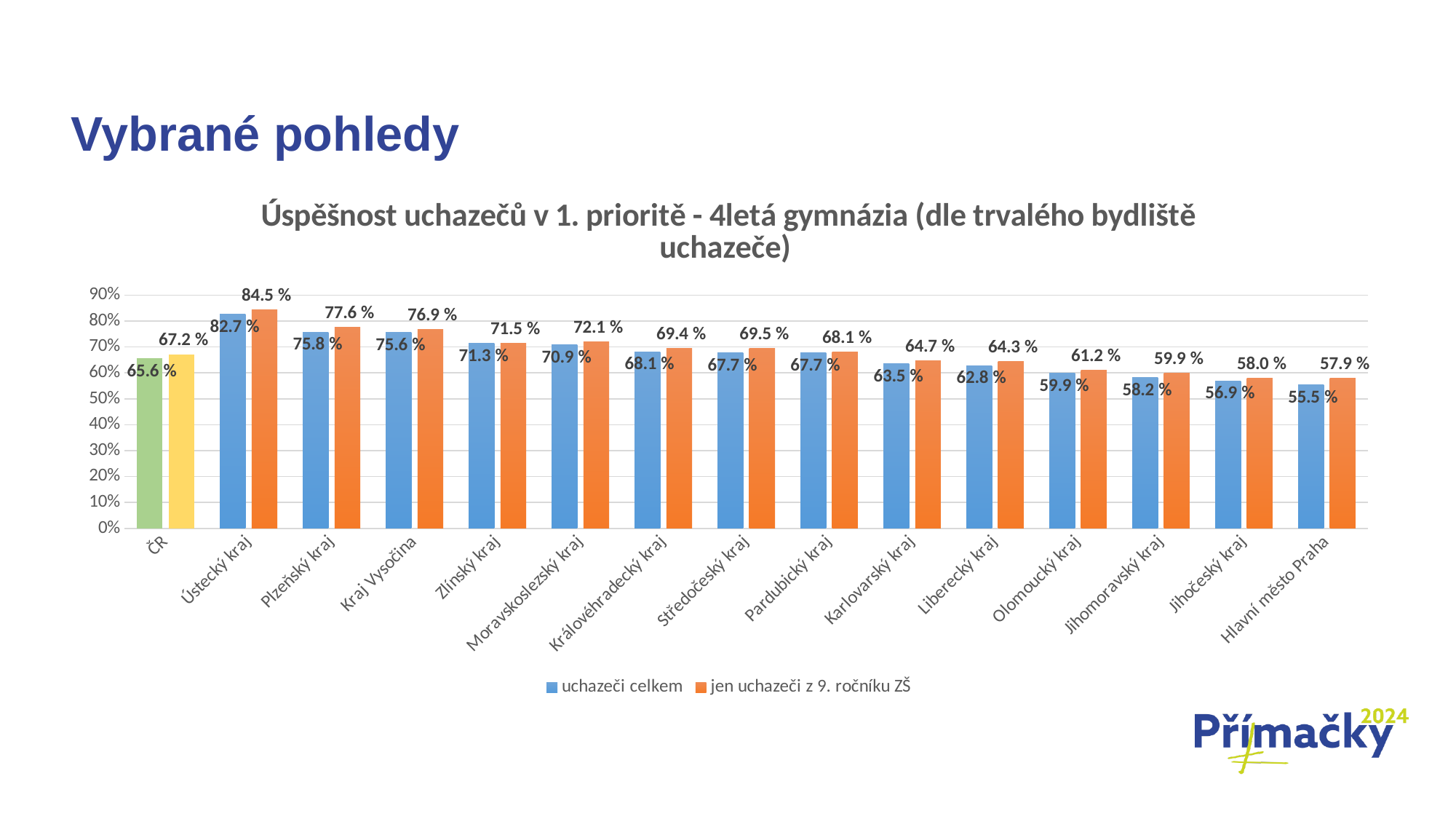
How many categories are shown on the x axis? 15 What type of chart is shown on the slide? bar chart How many series does the legend list? 2 Do the 'uchazeči celkem' values generally rise or fall from Ústecký kraj to Hlavní město Praha along the x axis? fall What is the value for 'jen uchazeči z 9. ročníku ZŠ' for Hlavní město Praha? 57.9 % What is the title of the chart? Úspěšnost uchazečů v 1. prioritě - 4letá gymnázia (dle trvalého bydliště uchazeče) What is the value for 'jen uchazeči z 9. ročníku ZŠ' for ČR? 67.2 % Which category has the lowest value for 'uchazeči celkem'? Hlavní město Praha Which region has the highest value for 'jen uchazeči z 9. ročníku ZŠ'? Ústecký kraj Which is larger: the 'uchazeči celkem' value for Plzeňský kraj or for Olomoucký kraj? Plzeňský kraj What is the difference between the 'jen uchazeči z 9. ročníku ZŠ' and 'uchazeči celkem' values for Ústecký kraj? 1.8 % What is the value for 'uchazeči celkem' for Ústecký kraj? 82.7 %